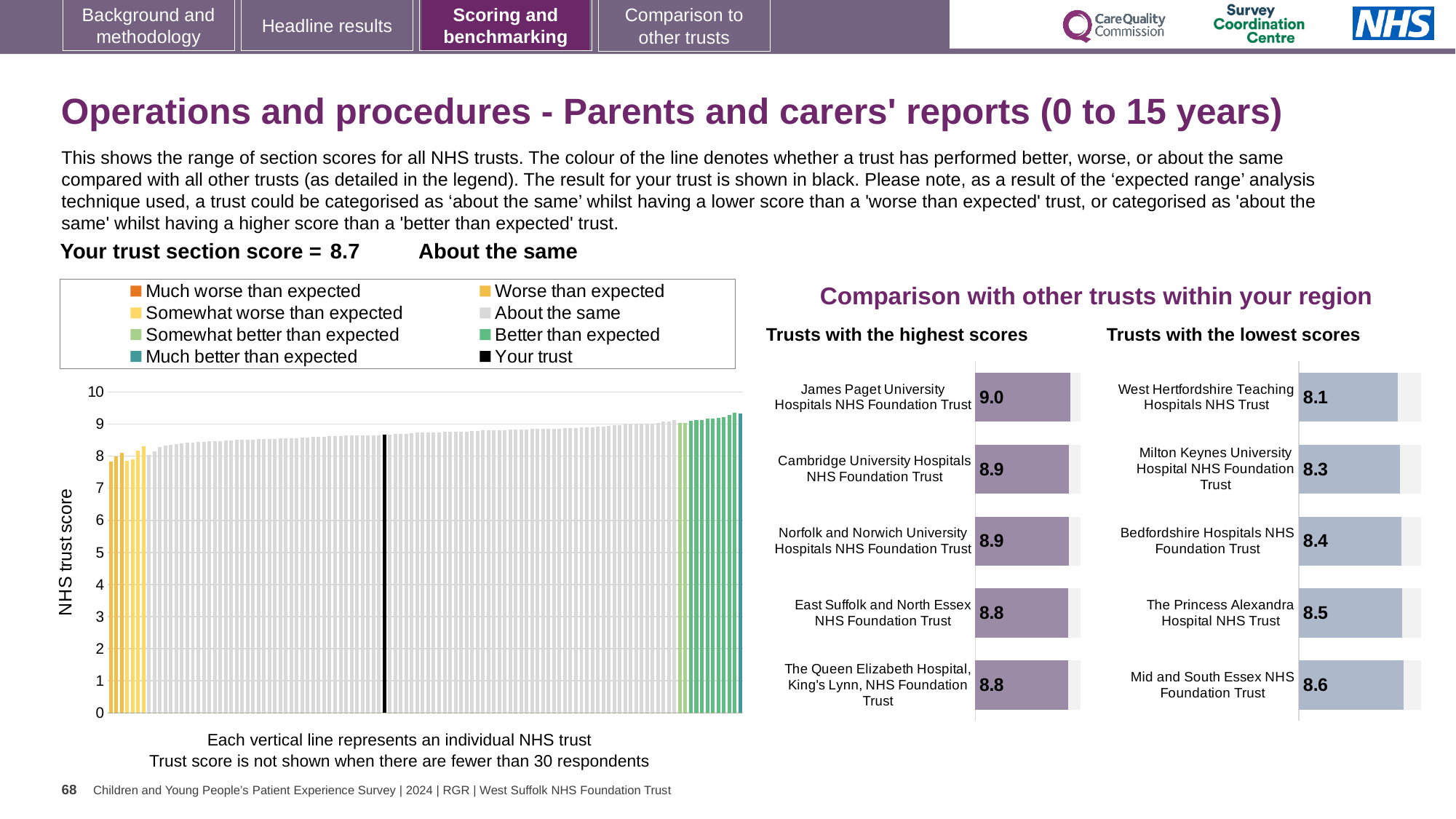
In the 'Trusts with the highest scores' chart, what is the difference between the scores of James Paget University Hospitals NHS Foundation Trust and East Suffolk and North Essex NHS Foundation Trust? 0.2 In the 'Trusts with the lowest scores' chart, what is the score for Bedfordshire Hospitals NHS Foundation Trust? 8.4 What is the y-axis label of the large chart on the left? NHS trust score In the 'Trusts with the highest scores' chart, which trust has the highest score? James Paget University Hospitals NHS Foundation Trust In the large chart on the left, is the value for the black 'Your trust' bar greater or less than 8? greater What kind of chart is the large chart on the left showing NHS trust scores? Bar chart In the 'Trusts with the highest scores' chart, what is the score for James Paget University Hospitals NHS Foundation Trust? 9.0 In the 'Trusts with the lowest scores' chart, which trust has the lowest score? West Hertfordshire Teaching Hospitals NHS Trust In the 'Trusts with the lowest scores' chart, which has the larger score: Milton Keynes University Hospital NHS Foundation Trust or Bedfordshire Hospitals NHS Foundation Trust? Bedfordshire Hospitals NHS Foundation Trust In the 'Trusts with the lowest scores' chart, what is the difference between the scores of Mid and South Essex NHS Foundation Trust and West Hertfordshire Teaching Hospitals NHS Trust? 0.5 How many trusts are shown in the 'Trusts with the highest scores' chart? 5 How many entries does the legend of the large chart on the left list? 8